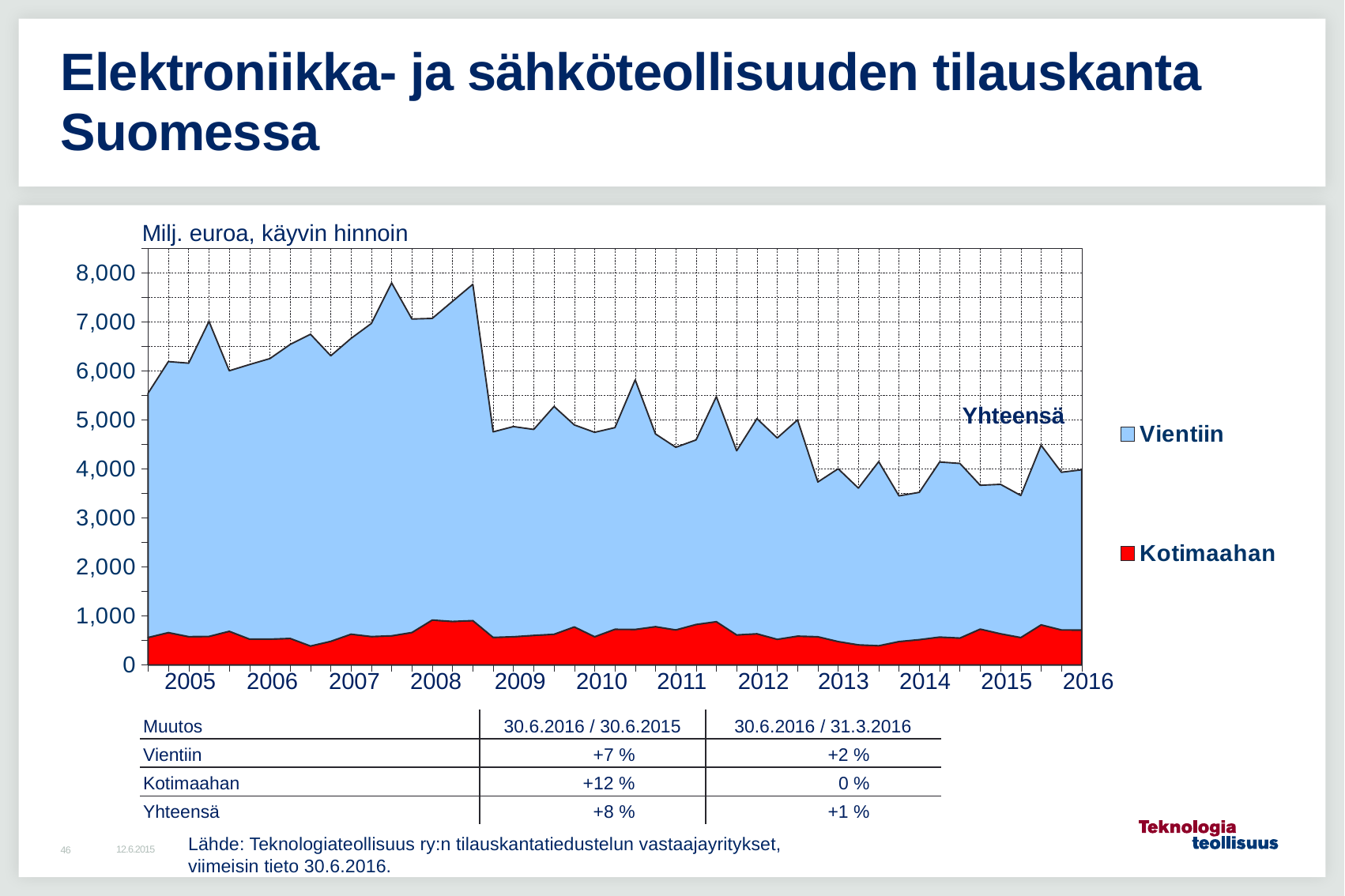
Which series is larger throughout the chart, Vientiin or Kotimaahan? Vientiin Is the Kotimaahan value in 2016 greater or less than 1,000? less Is the total (Yhteensä) value at the end of the chart in 2016 greater or less than 5,000? less Is the total (Yhteensä) value at the start of 2005 greater or less than 5,000? greater How many years are labelled on the chart's x axis? 12 What kind of chart is shown on the slide? area chart Which series is shown in red in the chart? Kotimaahan How many series does the chart legend list? 2 Does the total (Yhteensä) value generally rise or fall from 2008 to 2016? fall What unit label is printed above the chart's y axis? Milj. euroa, käyvin hinnoin